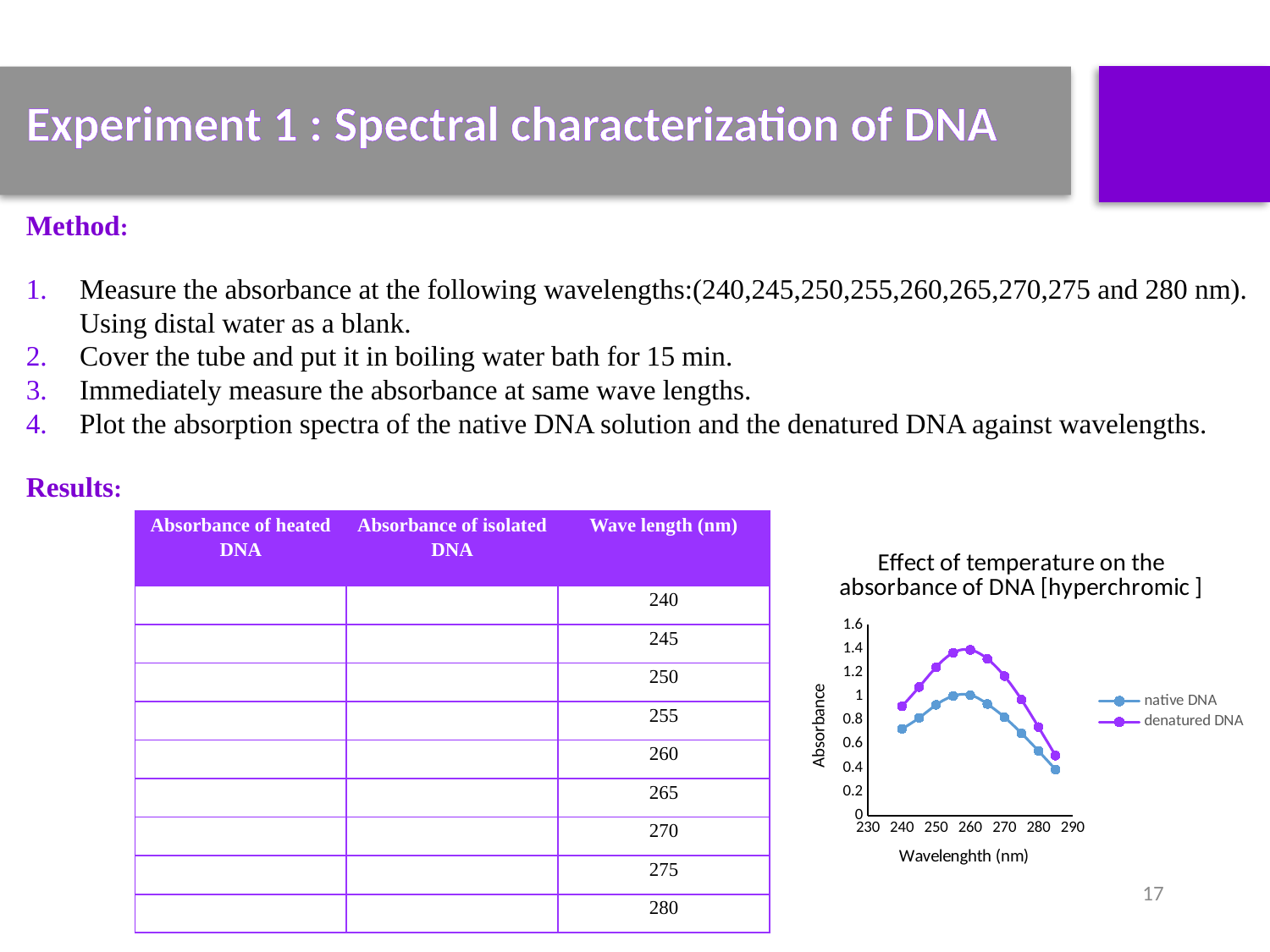
What are the two series named in the chart legend? native DNA and denatured DNA Is the absorbance of native DNA at 260 nm greater or less than 1.2? less Is the absorbance of native DNA at 240 nm greater or less than 0.8? less How many series does the chart legend list? 2 Do the absorbance values for native DNA rise or fall between 240 nm and 255 nm? rise How many data points are plotted for the native DNA series? 10 Do the absorbance values for denatured DNA rise or fall between 260 nm and 280 nm? fall What is the title of the chart? Effect of temperature on the absorbance of DNA [hyperchromic ] Is the absorbance of denatured DNA at 260 nm greater or less than 1.2? greater What kind of chart is shown on the slide? line chart At 260 nm, which series has the higher absorbance, native DNA or denatured DNA? denatured DNA